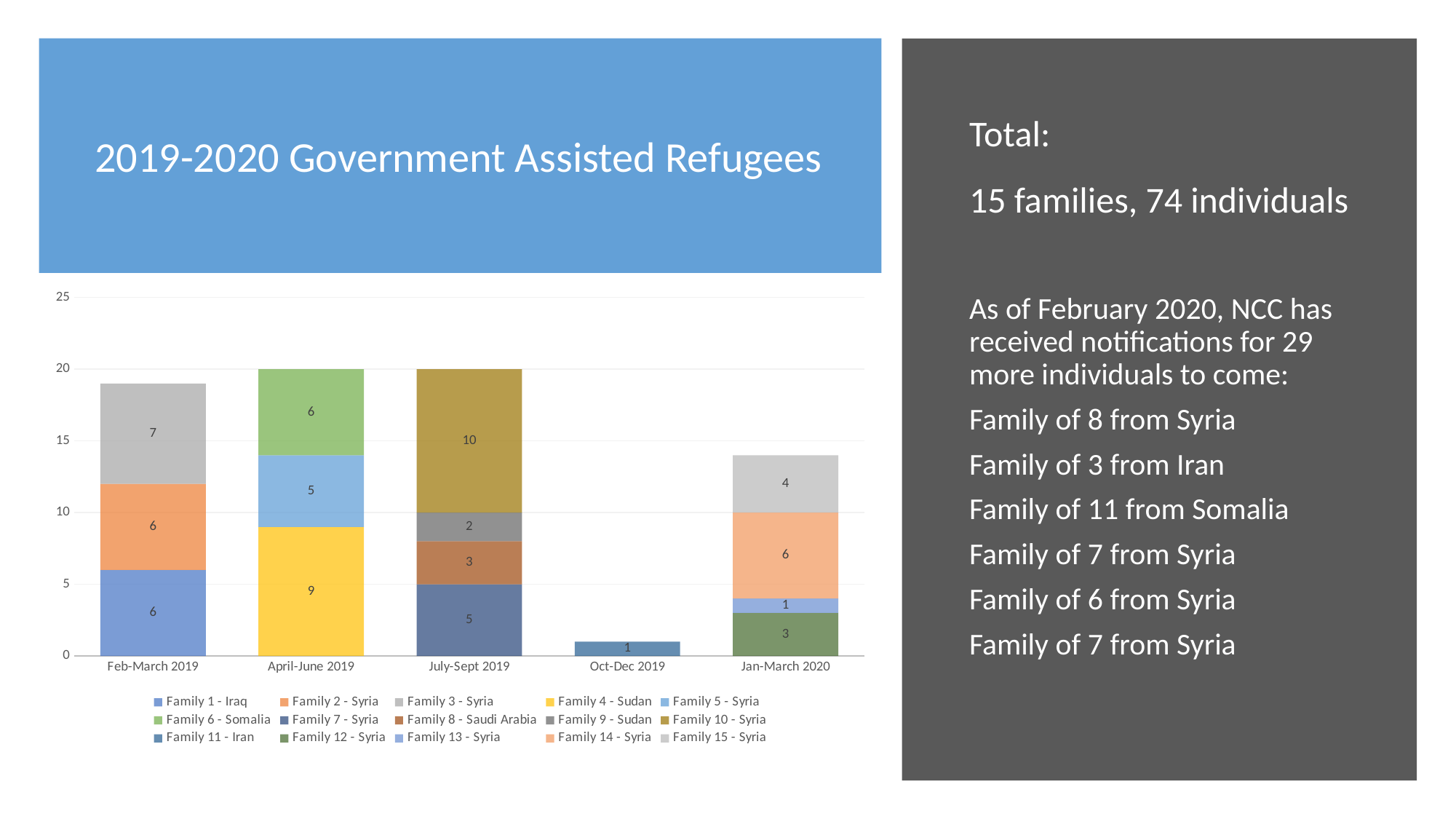
Which time period has the lowest total bar? Oct-Dec 2019 What is the value for Family 11 - Iran in Oct-Dec 2019? 1 How many time periods are shown on the x axis of the chart? 5 What is the title of the chart? 2019-2020 Government Assisted Refugees How many families (series) does the chart legend list? 15 What is the difference between the values for Family 3 - Syria (7) and Family 15 - Syria (4)? 3 What type of chart is shown on the slide? Stacked bar chart What is the total of the stacked bar for Feb-March 2019? 19 Which is larger: the value for Family 6 - Somalia or the value for Family 5 - Syria? Family 6 - Somalia What is the value for Family 4 - Sudan in April-June 2019? 9 What is the value for Family 10 - Syria in July-Sept 2019? 10 What is the total of the stacked bar for Jan-March 2020? 14